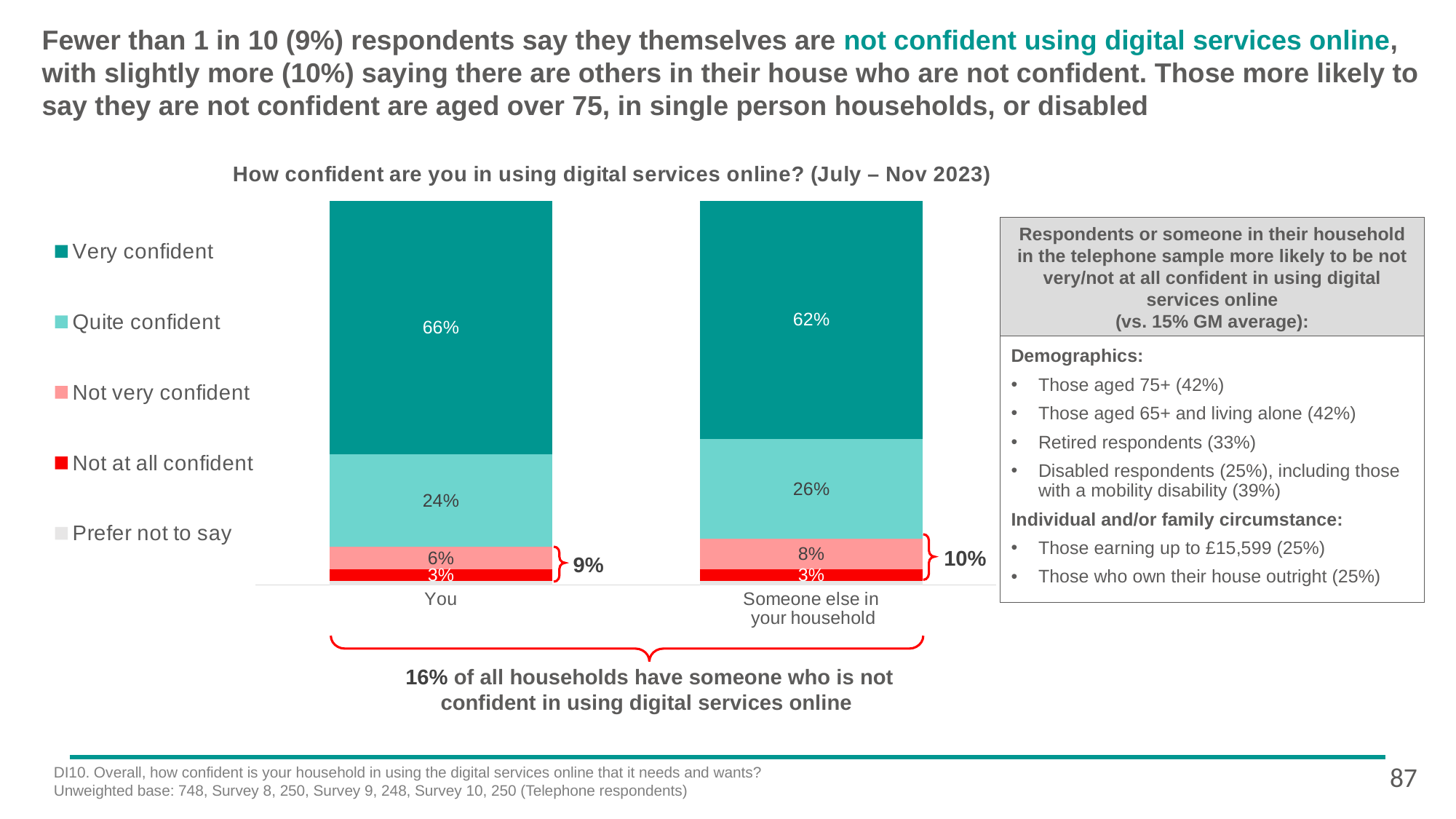
What is the difference between the 'Not very confident' values for 'Someone else in your household' and 'You'? 2 percentage points What type of chart is shown on the slide? Stacked bar chart What percentage of respondents say they themselves ('You') are very confident in using digital services online? 66% Which response category makes up the largest segment of the 'You' bar? Very confident What percentage are 'Quite confident' for the 'Someone else in your household' bar? 26% By how many percentage points does the 'Very confident' share for 'You' exceed that for 'Someone else in your household'? 4 percentage points What is the 'Not at all confident' value for 'Someone else in your household'? 3% How many series does the chart legend list? 5 How many bars (categories) are plotted in the chart? 2 What is the 'Not very confident' value for the 'You' bar? 6% What combined percentage is shown by the bracket next to the 'You' bar for those not confident? 9% Which bar has the larger 'Quite confident' share, 'You' or 'Someone else in your household'? Someone else in your household